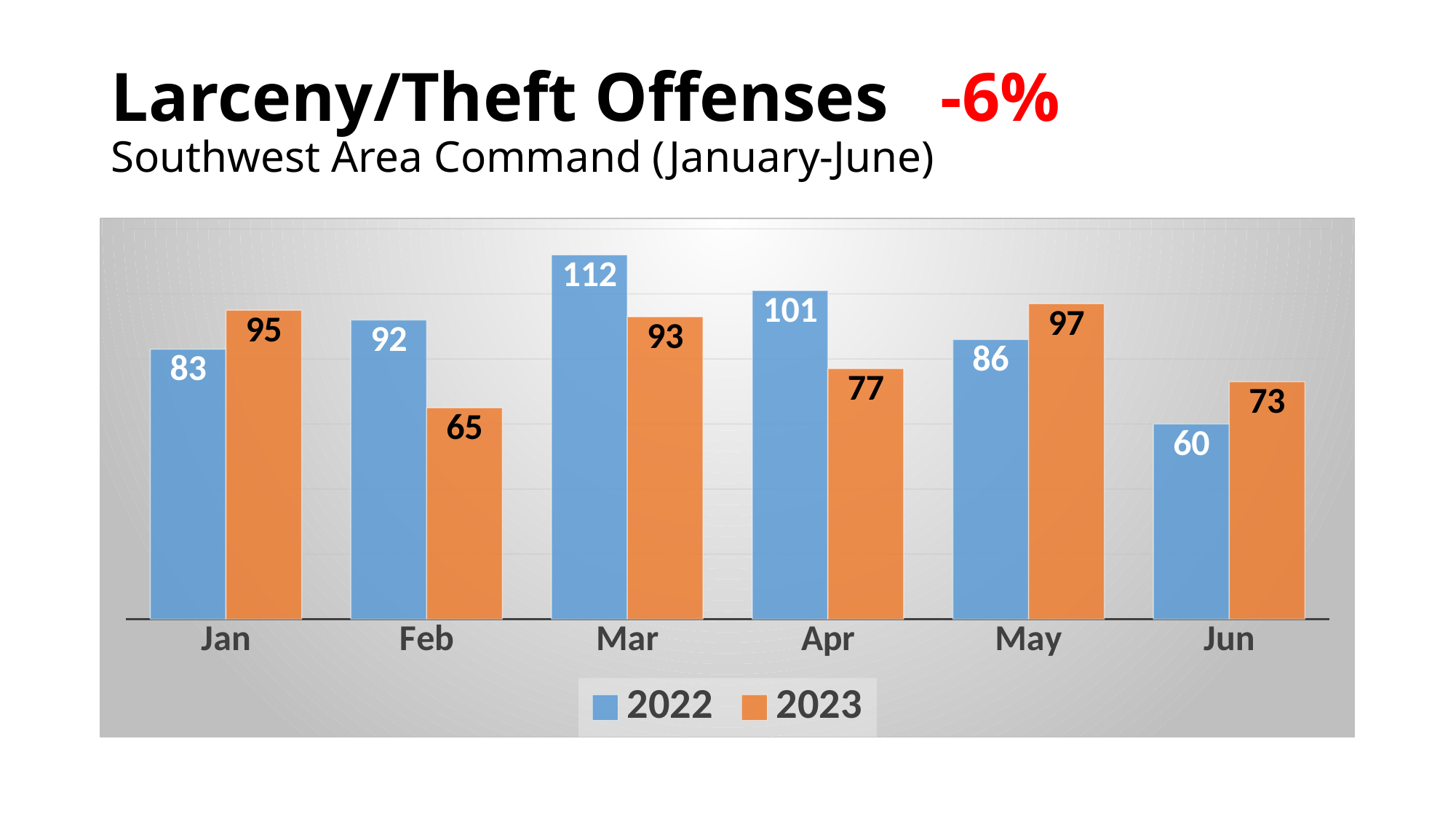
What is the value for 2023 in Jun? 73 What kind of chart is shown on the slide? bar chart Which is larger in May, the 2022 value or the 2023 value? 2023 What is the value for 2022 in Mar? 112 What is the value for 2023 in Feb? 65 What is the title of the chart? Larceny/Theft Offenses How many series does the legend list? 2 Which month has the lowest value for 2023? Feb What is the difference between the 2022 and 2023 values in Apr? 24 How many months are shown on the x axis? 6 What percentage change is shown in red next to the title? -6% Which month has the highest value for 2022? Mar